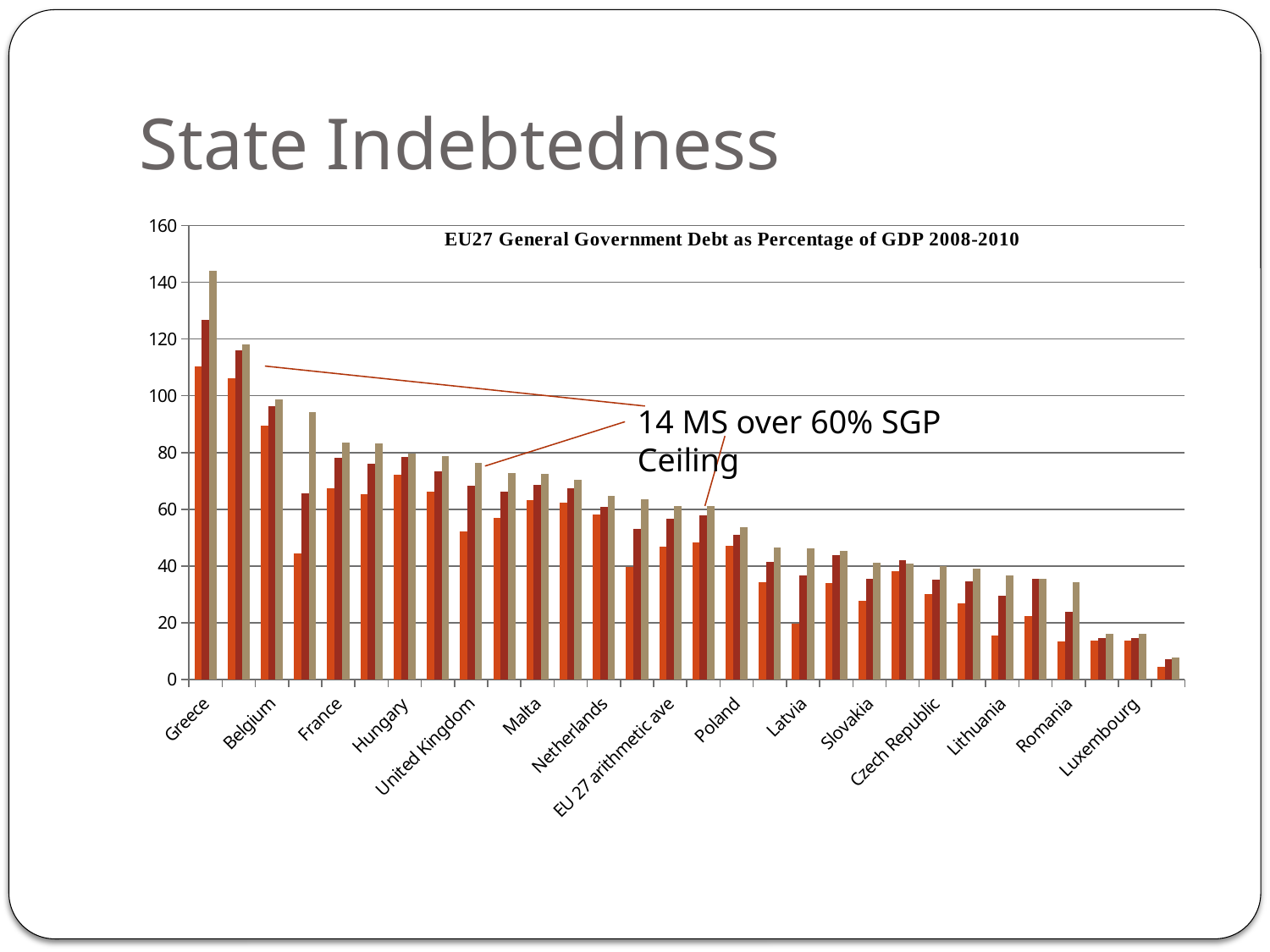
Is the tallest bar for Luxembourg greater or less than 20? less Do the debt values generally rise or fall moving from left to right along the x axis? fall Is the tallest bar for France greater or less than 60? greater Is the tallest bar for Greece greater or less than 140? greater Which country has the highest government debt as a percentage of GDP in the chart? Greece How many bars are plotted for each country in the chart? 3 What does the annotation on the chart say about the 60% SGP ceiling? 14 MS over 60% SGP Ceiling What kind of chart is shown on the slide? bar chart Which has higher government debt as a percentage of GDP, Greece or Belgium? Greece What is the title of the chart? EU27 General Government Debt as Percentage of GDP 2008-2010